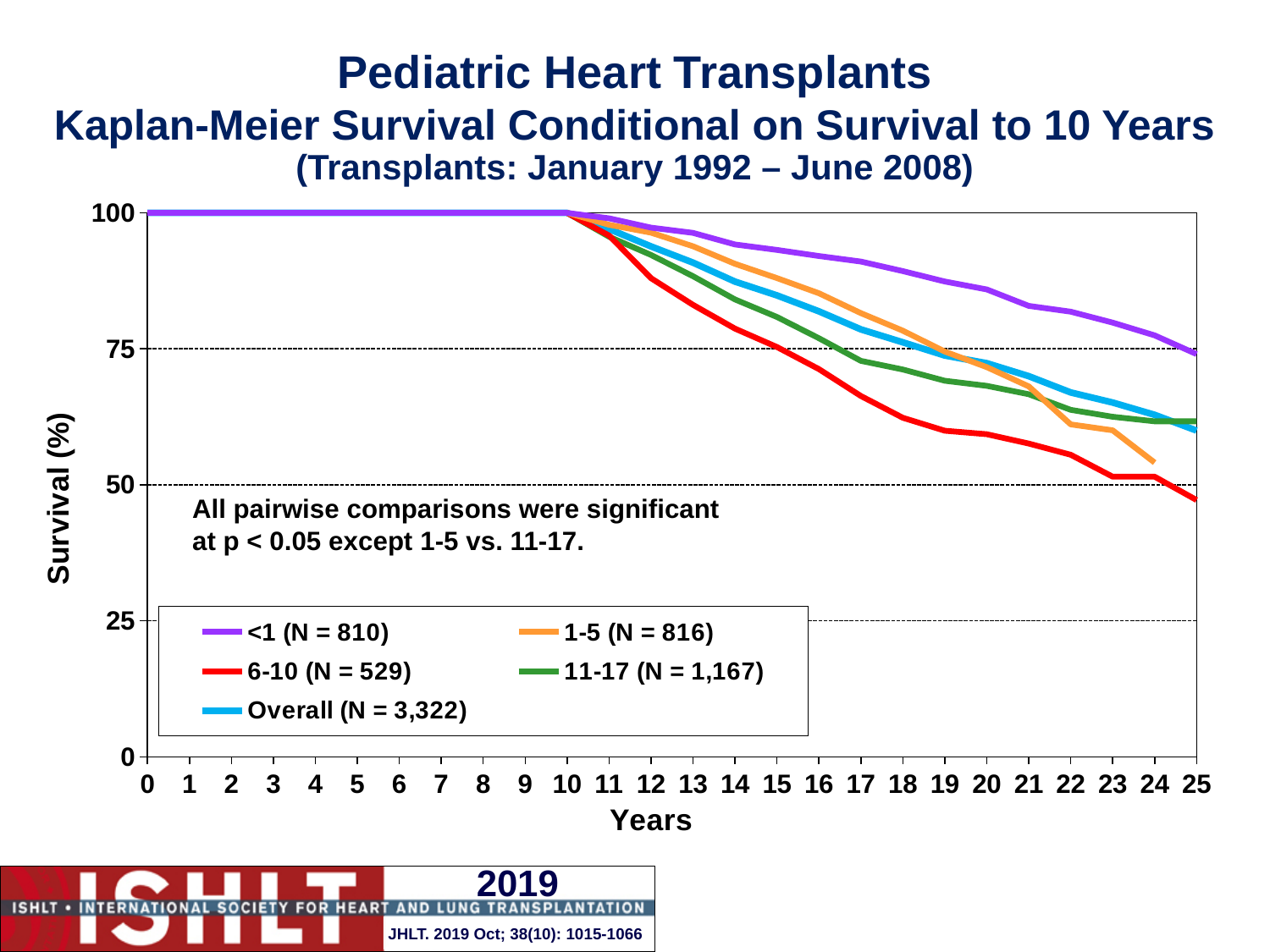
What kind of chart is shown on the slide? line chart At 20 years, which group has higher survival, <1 or 6-10? <1 Which group has the highest survival at 25 years? <1 How many series does the legend list? 5 Do the survival curves rise or fall after year 10 along the x axis? fall Which group has the lowest survival at 25 years? 6-10 What is the survival value for the Overall group at 10 years? 100 Is the survival value for the 6-10 group at 25 years greater or less than 50? less Is the survival value for the <1 group at 20 years greater or less than 75? greater Is the survival value for the Overall group at 20 years greater or less than 75? less What is the N shown in the legend for the Overall group? 3,322